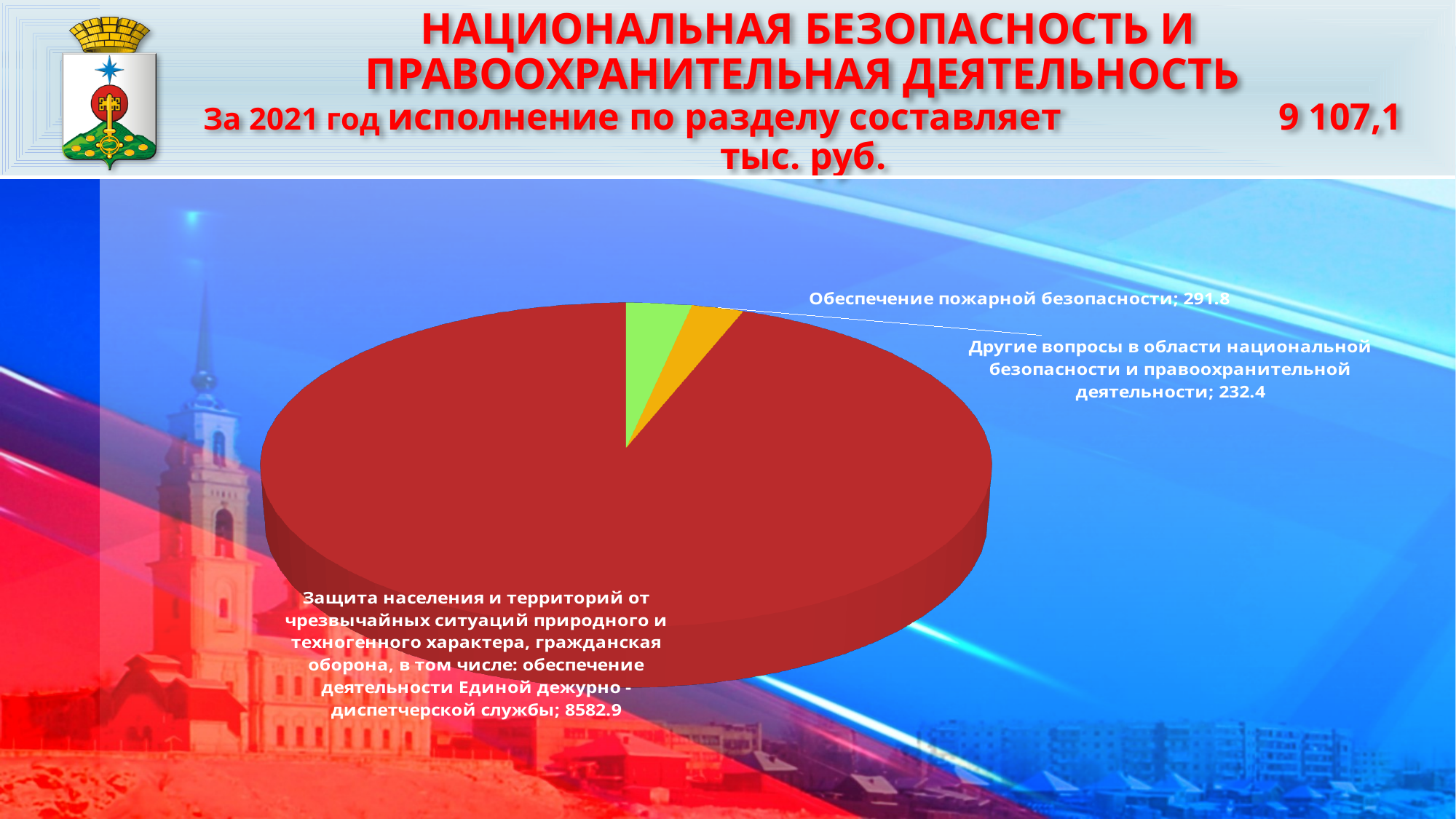
How many slices does the pie chart have? 3 What is the difference between the values for "Обеспечение пожарной безопасности" and "Другие вопросы в области национальной безопасности и правоохранительной деятельности"? 59.4 What is the value for "Другие вопросы в области национальной безопасности и правоохранительной деятельности"? 232.4 What is the value for "Защита населения и территорий от чрезвычайных ситуаций природного и техногенного характера, гражданская оборона, в том числе: обеспечение деятельности Единой дежурно-диспетчерской службы"? 8582.9 Which category has the smallest value in the pie chart? Другие вопросы в области национальной безопасности и правоохранительной деятельности Which is larger: "Обеспечение пожарной безопасности" or "Другие вопросы в области национальной безопасности и правоохранительной деятельности"? Обеспечение пожарной безопасности What is the value for "Обеспечение пожарной безопасности"? 291.8 According to the slide heading, what is the total execution for the section for 2021? 9 107,1 тыс. руб. Which category has the largest value in the pie chart? Защита населения и территорий от чрезвычайных ситуаций природного и техногенного характера, гражданская оборона, в том числе: обеспечение деятельности Единой дежурно-диспетчерской службы What is the difference between the largest slice (8582.9) and "Обеспечение пожарной безопасности" (291.8)? 8291.1 What kind of chart is shown on the slide? Pie chart What is the total of all three slices in the pie chart? 9107.1